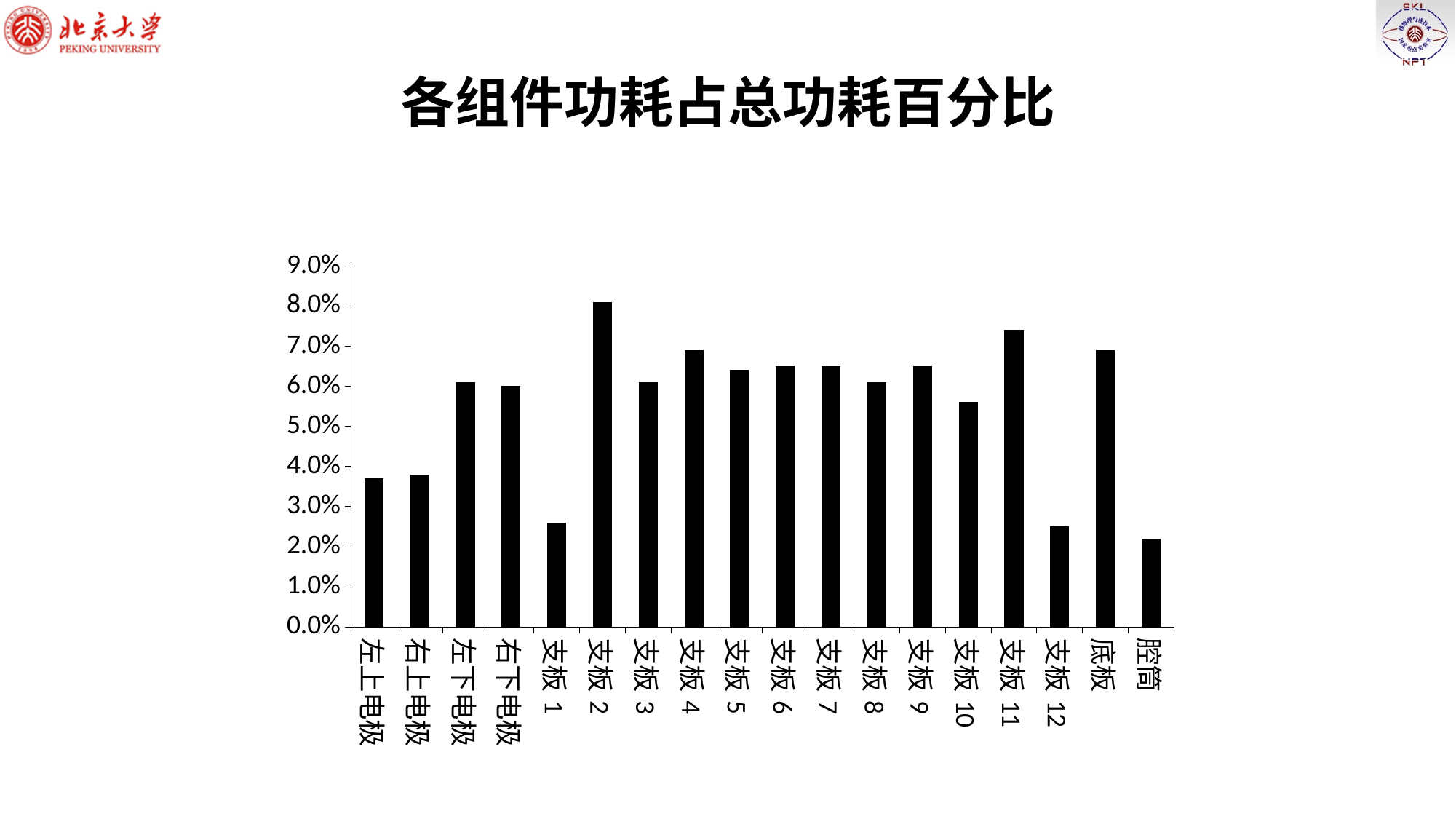
What is the title of the chart? 各组件功耗占总功耗百分比 Is the value for 左上电极 greater or less than 4.0%? less Is the value for 支板 11 greater or less than 7.0%? greater Which category has the lowest value? 腔筒 Which is larger, the value for 支板 11 or the value for 支板 10? 支板 11 What kind of chart is shown on the slide? bar chart Is the value for 支板 10 greater or less than 5.0%? greater Which category has the highest value? 支板 2 Which is larger, the value for 左下电极 or the value for 支板 1? 左下电极 How many categories are plotted on the x axis? 18